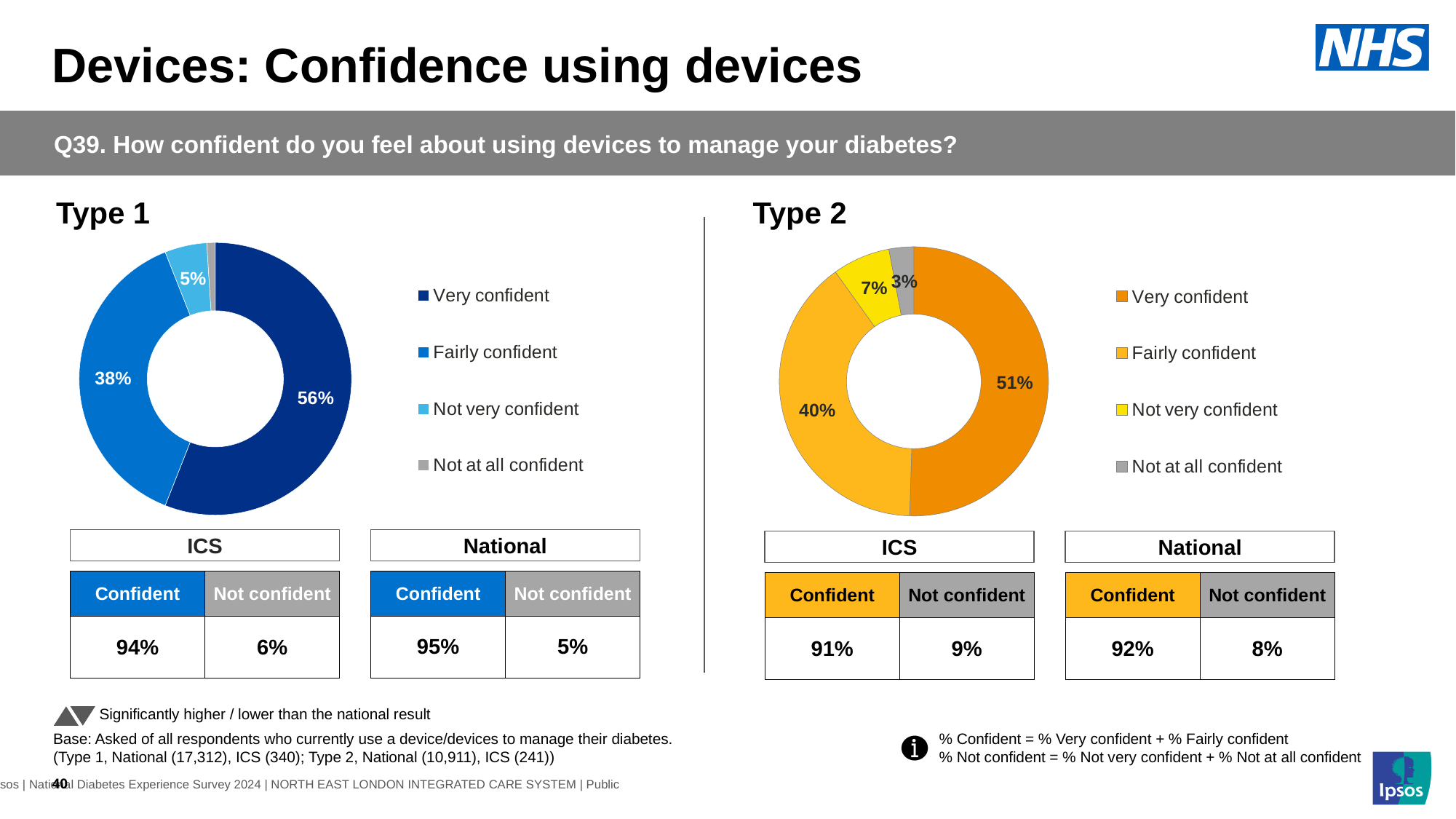
In the Type 1 chart, what is the difference between the very confident and fairly confident shares? 18 percentage points In the Type 2 chart, what is the difference between the fairly confident and not very confident shares? 33 percentage points Which is larger: the very confident share in the Type 1 chart or the very confident share in the Type 2 chart? Type 1 In the Type 2 chart, which category has the smallest share? Not at all confident In the Type 1 chart, what percentage of respondents are very confident? 56% What type of chart is used for Type 1? Donut chart In the Type 2 chart, what percentage of respondents are not at all confident? 3% In the Type 2 chart, which category has the largest share? Very confident In the Type 1 chart, what percentage of respondents are not very confident? 5% In the Type 1 chart, what percentage of respondents are fairly confident? 38% How many categories does the legend of the Type 2 chart list? 4 In the Type 2 chart, what percentage of respondents are very confident? 51%